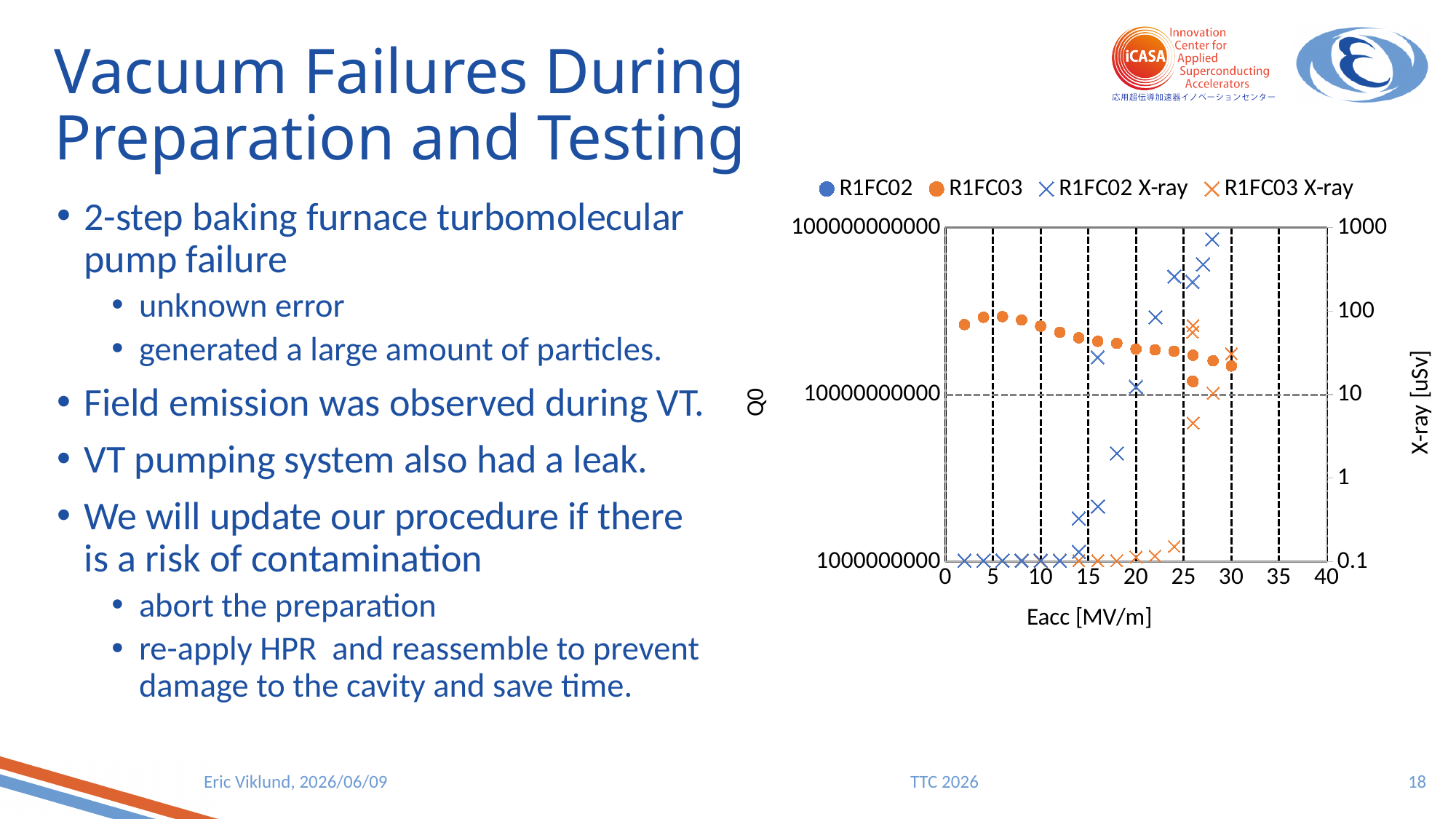
How many series does the chart legend list? 4 What is the label of the right-hand y axis of the chart? X-ray [uSv] Is the R1FC03 Q0 value at 30 MV/m greater or less than 10000000000? greater What kind of chart is shown on the slide? Scatter plot Do the R1FC02 X-ray values rise or fall as Eacc increases? rise What is the maximum value shown on the x axis of the chart? 40 Which series reaches the highest X-ray value on the chart? R1FC02 X-ray Do the R1FC03 Q0 values rise or fall as Eacc increases? fall What is the highest tick value shown on the right-hand X-ray axis? 1000 Is the R1FC02 X-ray value at 28 MV/m greater or less than 100 uSv? greater Is the R1FC02 X-ray value at 10 MV/m greater or less than 1 uSv? less What is the label of the x axis of the chart? Eacc [MV/m]